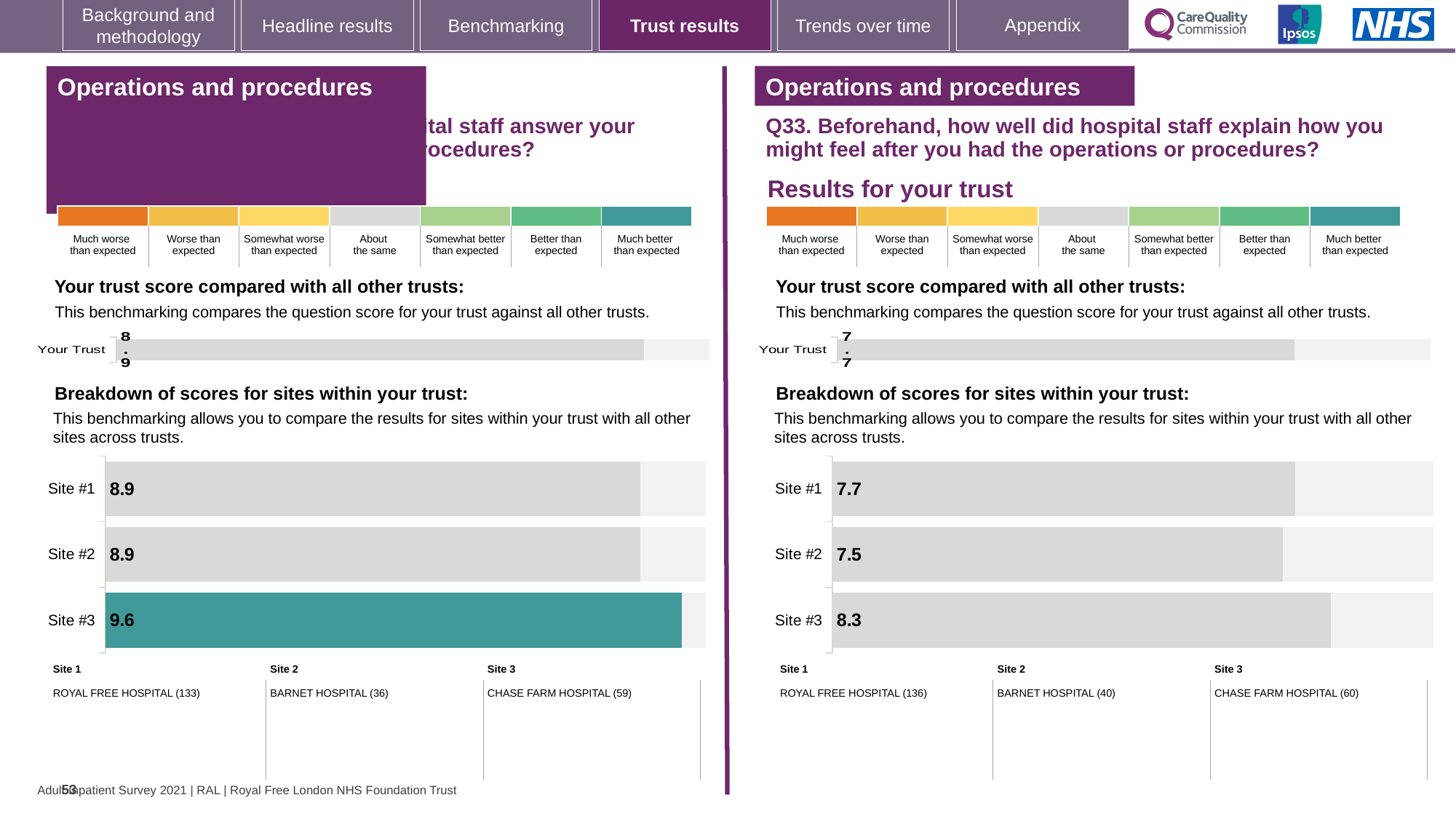
In the left-hand 'Your trust score compared with all other trusts' chart, what is the score for Your Trust? 8.9 How many sites are shown in the Q33 site breakdown chart on the right? 3 In the Q33 site breakdown chart on the right, what is the score for Site #2? 7.5 In the left-hand site breakdown chart, what is the score for Site #1? 8.9 In the Q33 site breakdown chart on the right, what is the difference between the scores for Site #3 and Site #2? 0.8 In the left-hand site breakdown chart, what is the difference between the scores for Site #3 and Site #2? 0.7 In the Q33 site breakdown chart on the right, which is larger, the score for Site #1 or Site #3? Site #3 In the left-hand site breakdown chart, which site has the highest score? Site #3 In the Q33 site breakdown chart on the right, what is the score for Site #3? 8.3 In the Q33 site breakdown chart on the right, which site has the lowest score? Site #2 In the left-hand site breakdown chart, what is the score for Site #3? 9.6 What type of chart is used for the site breakdown on the left-hand side of the slide? Bar chart